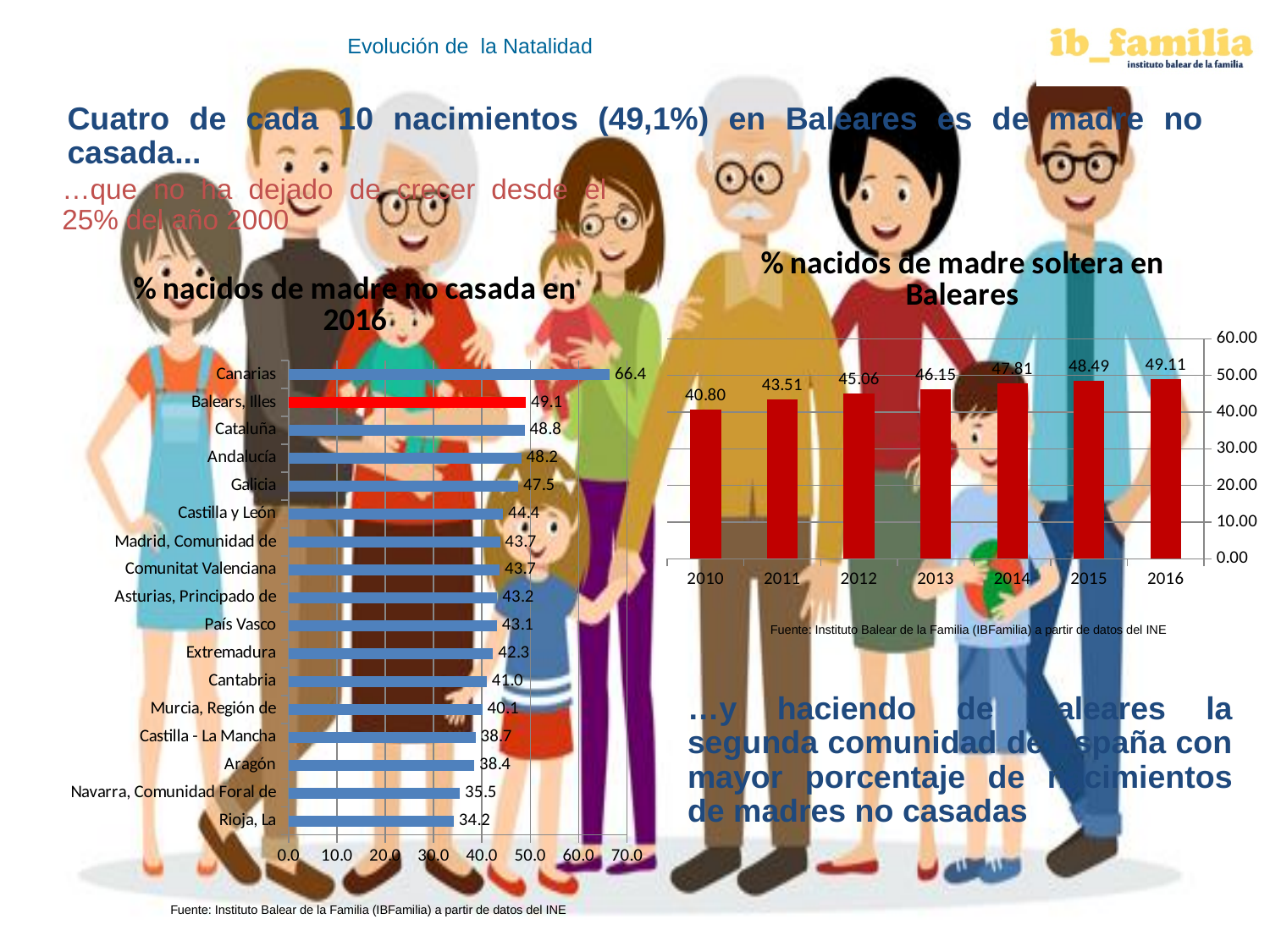
In the chart '% nacidos de madre soltera en Baleares', what is the difference between 2016 and 2010? 8.31 In the chart '% nacidos de madre soltera en Baleares', do the values rise or fall from 2010 to 2016? Rise In the chart '% nacidos de madre no casada en 2016', which category has the highest value? Canarias In the chart '% nacidos de madre no casada en 2016', what is the difference between Canarias and Balears, Illes? 17.3 In the chart '% nacidos de madre no casada en 2016', what is the value for Balears, Illes? 49.1 What kind of chart is '% nacidos de madre soltera en Baleares'? Bar chart In the chart '% nacidos de madre soltera en Baleares', what is the value for 2010? 40.80 In the chart '% nacidos de madre no casada en 2016', which category has the lowest value? Rioja, La In the chart '% nacidos de madre soltera en Baleares', what is the value for 2016? 49.11 In the chart '% nacidos de madre no casada en 2016', which is larger, Galicia or Aragón? Galicia In the chart '% nacidos de madre no casada en 2016', how many categories are shown? 17 In the chart '% nacidos de madre no casada en 2016', what is the value for Canarias? 66.4